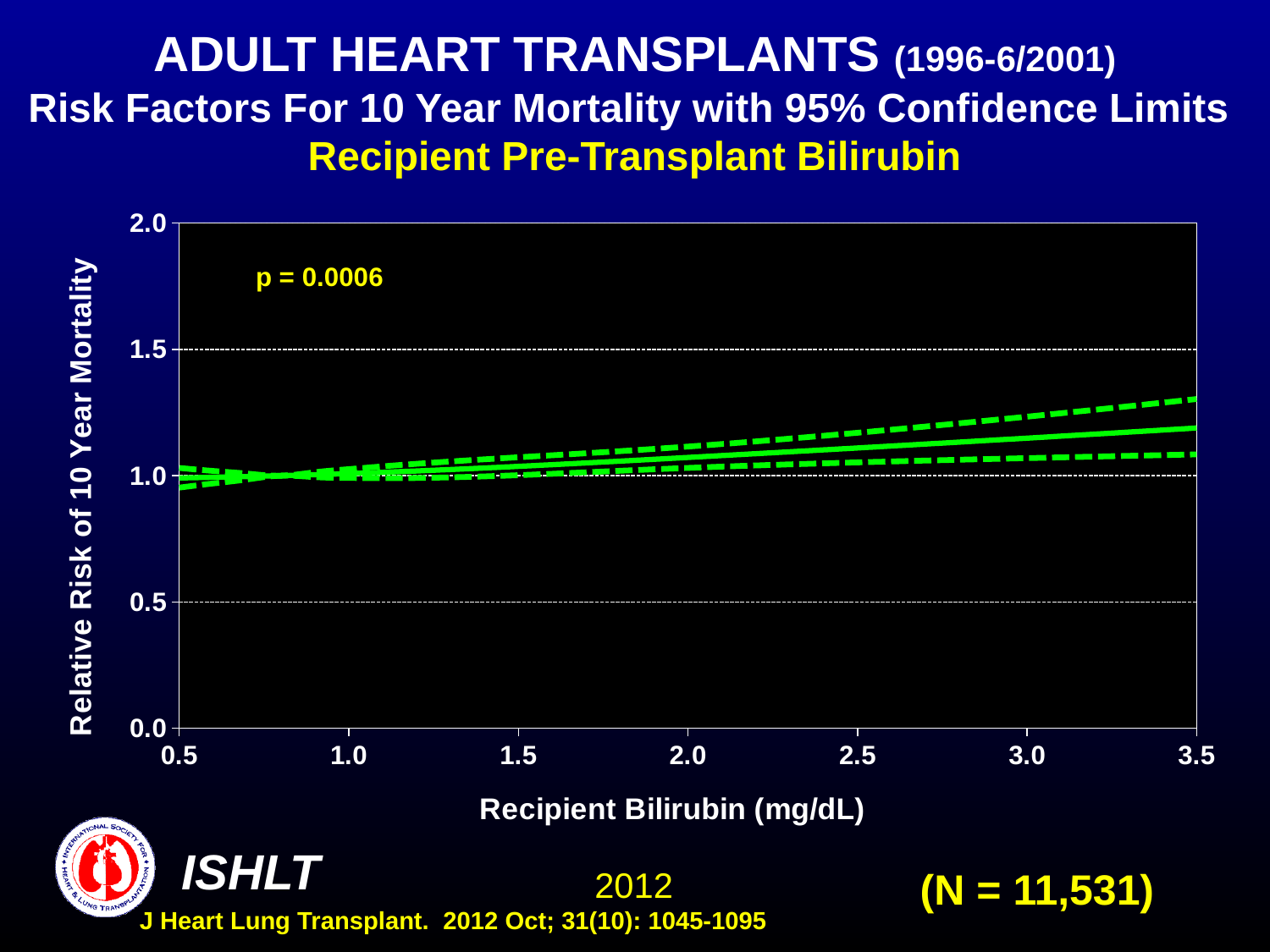
What is the lowest recipient bilirubin value shown on the x axis? 0.5 Does the relative risk of 10 year mortality rise or fall as recipient bilirubin increases from 0.5 to 3.5 mg/dL? rise Is the relative risk of 10 year mortality at a recipient bilirubin of 3.5 mg/dL greater or less than 1.5? less What is the label of the x axis? Recipient Bilirubin (mg/dL) What p-value is printed on the chart? p = 0.0006 Is the relative risk of 10 year mortality at a recipient bilirubin of 3.5 mg/dL greater or less than 1.0? greater What kind of chart is shown on the slide? line chart What is the highest value shown on the y axis? 2.0 Is the relative risk of 10 year mortality at a recipient bilirubin of 2.0 mg/dL greater or less than 0.5? greater